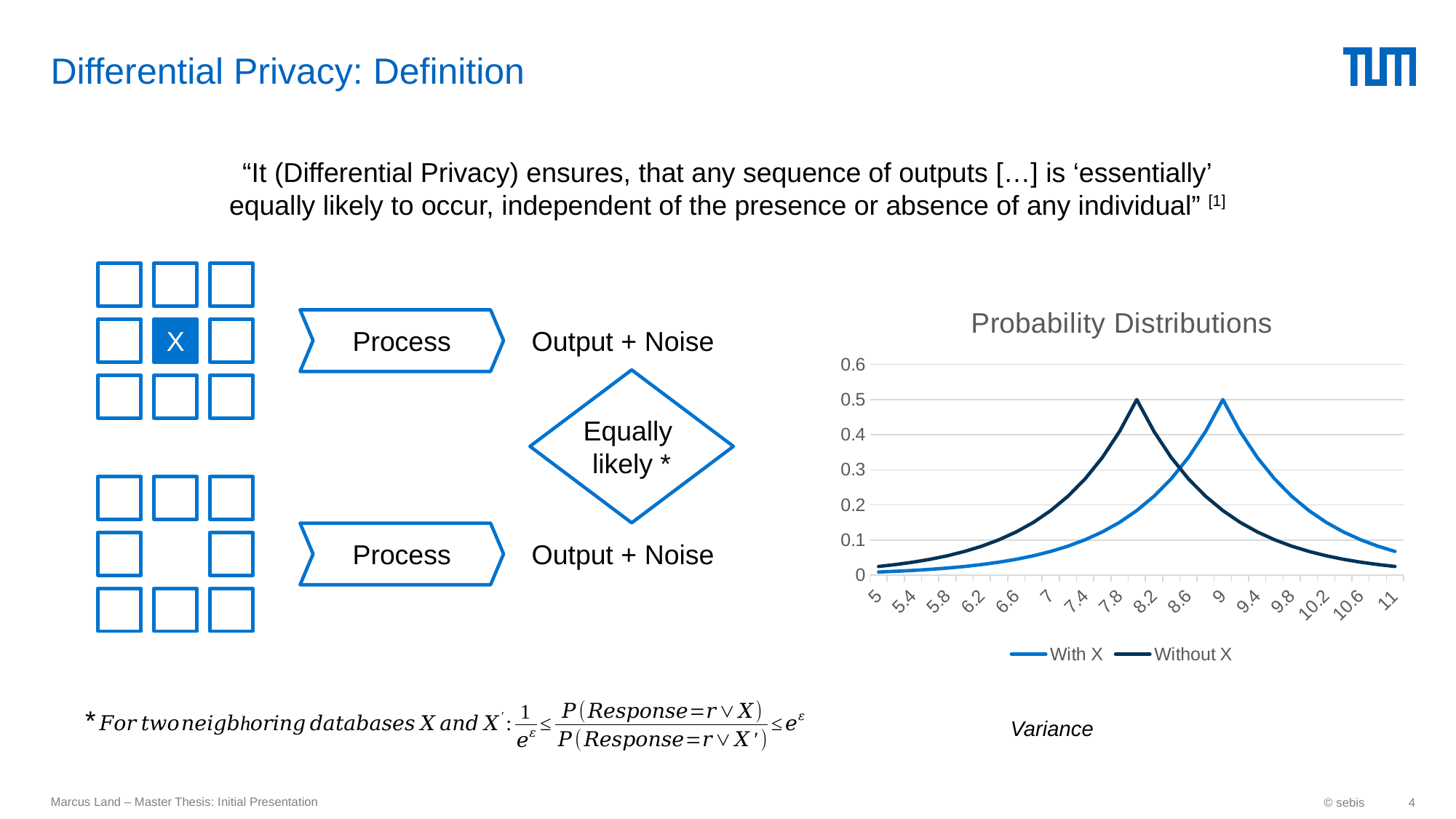
In the Probability Distributions chart, which series has the higher value at x = 10.2? With X In the Probability Distributions chart, is the value of the With X series at x = 9 greater or less than 0.4? greater How many series does the legend of the Probability Distributions chart list? 2 What is the title of the chart on the slide? Probability Distributions What kind of chart is the Probability Distributions chart? line chart In the Probability Distributions chart, is the value of the With X series at x = 5 greater or less than 0.1? less How many tick labels are shown on the x axis of the Probability Distributions chart? 16 In the Probability Distributions chart, is the value of the Without X series at x = 9 greater or less than 0.3? less What are the two legend entries in the Probability Distributions chart? With X, Without X In the Probability Distributions chart, which series has the higher value at x = 7? Without X In the Probability Distributions chart, does the Without X series rise or fall between x = 8.2 and x = 11? fall In the Probability Distributions chart, does the With X series rise or fall between x = 5 and x = 9? rise